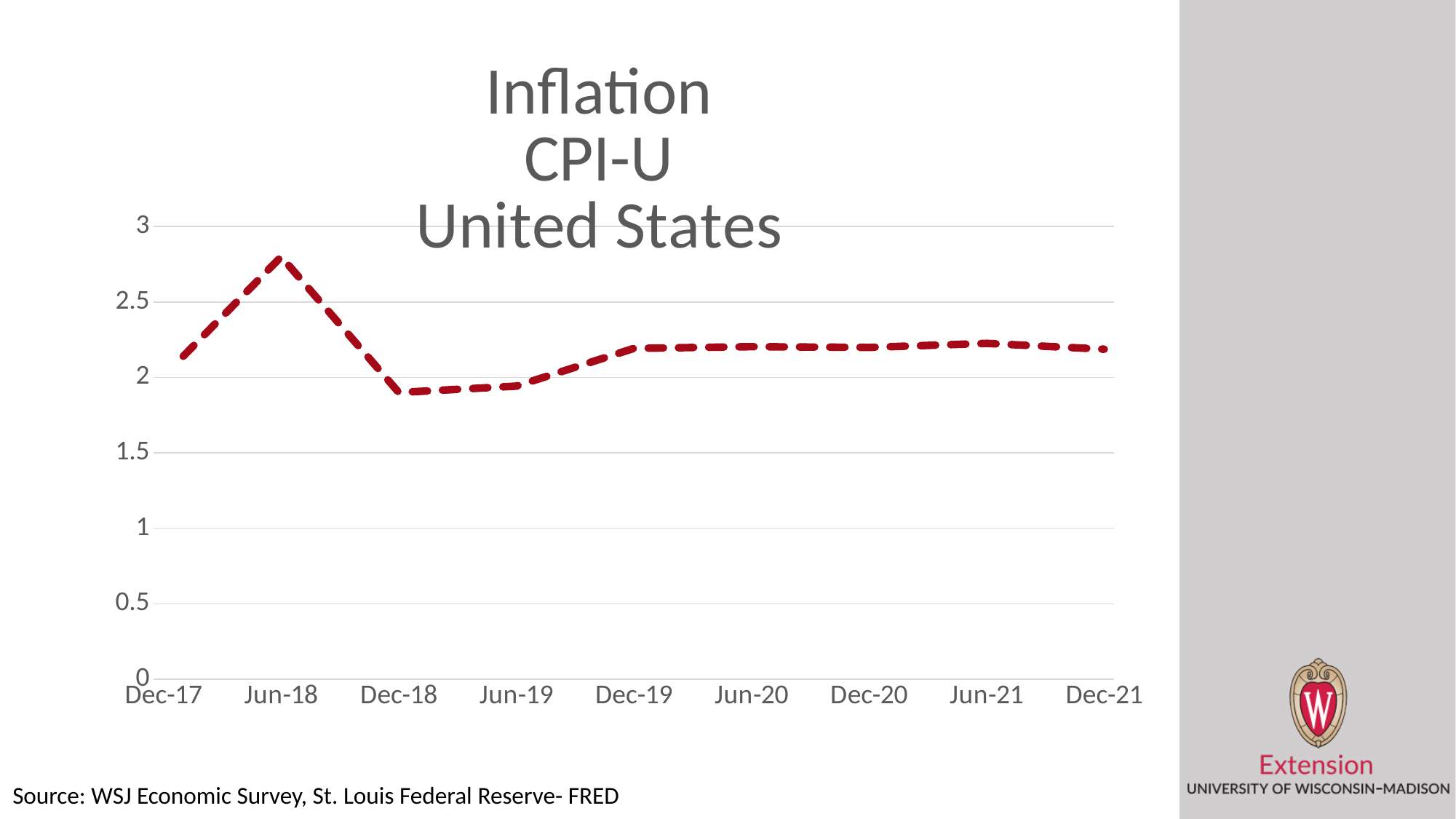
Is the value at Dec-17 greater or less than 2? greater Is the value at Jun-18 greater or less than 2.5? greater Which is larger, the value at Jun-18 or the value at Dec-18? Jun-18 Does the line rise or fall between Dec-17 and Jun-18? rise At which x-axis date does the line reach its highest value? Jun-18 Is the value at Dec-18 greater or less than 2? less Does the line rise or fall between Jun-18 and Dec-18? fall At which x-axis date does the line reach its lowest value? Dec-18 What kind of chart is shown on the slide? line chart How many date labels are shown on the x axis? 9 What is the title of the chart? Inflation CPI-U United States